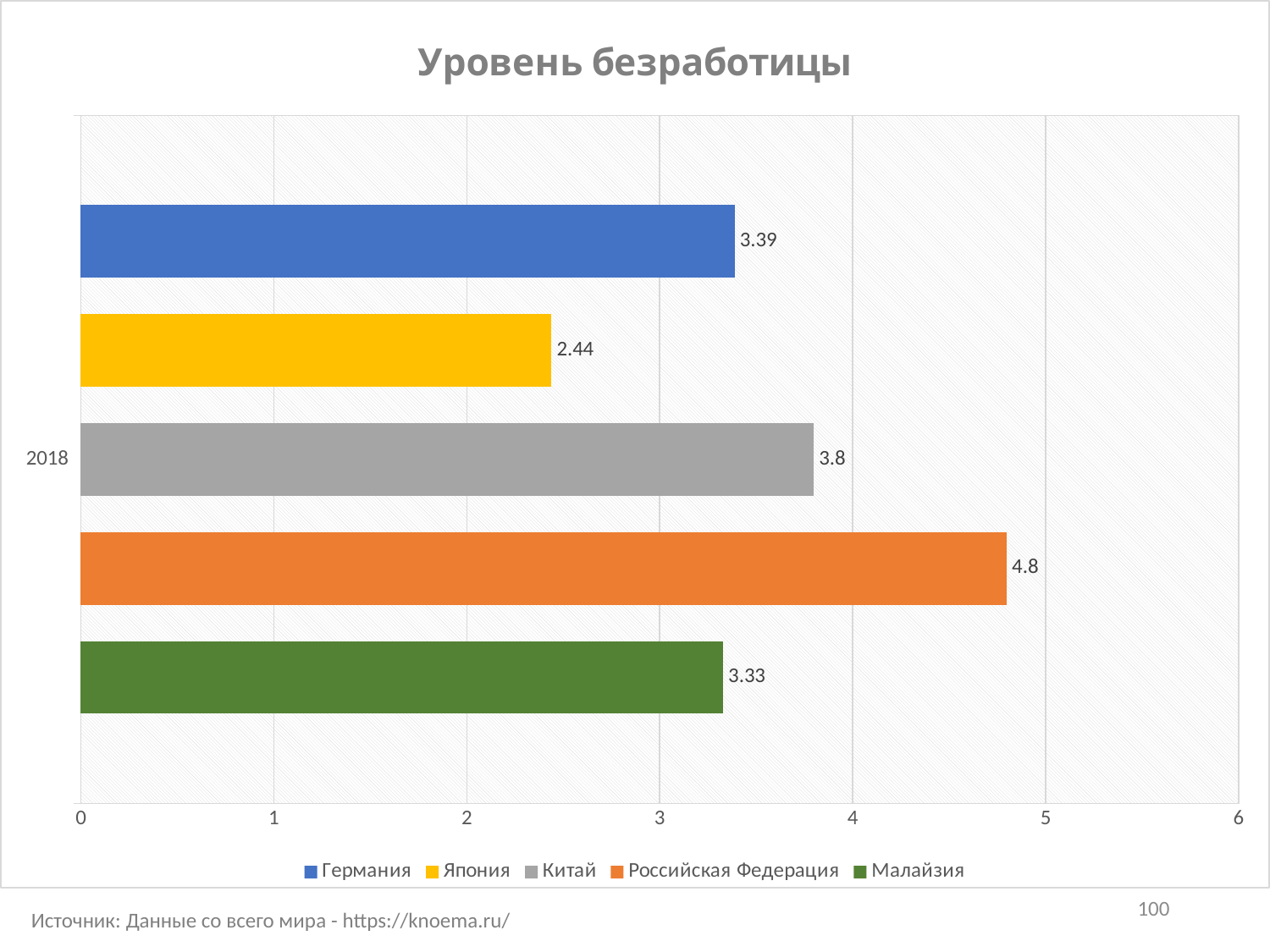
What is the unemployment rate value shown for Германия in 2018? 3.39 Which country has the highest unemployment rate on the chart? Российская Федерация What kind of chart is shown on the slide? bar chart What is the difference between the values for Российская Федерация and Япония? 2.36 How many series does the legend list? 5 Which is larger, the value for Китай or the value for Германия? Китай What value is shown for Малайзия? 3.33 What value is shown for Япония? 2.44 What is the title of the chart? Уровень безработицы What value is shown for Российская Федерация? 4.8 Is the value for Китай greater or less than 4? less Which country has the lowest unemployment rate on the chart? Япония